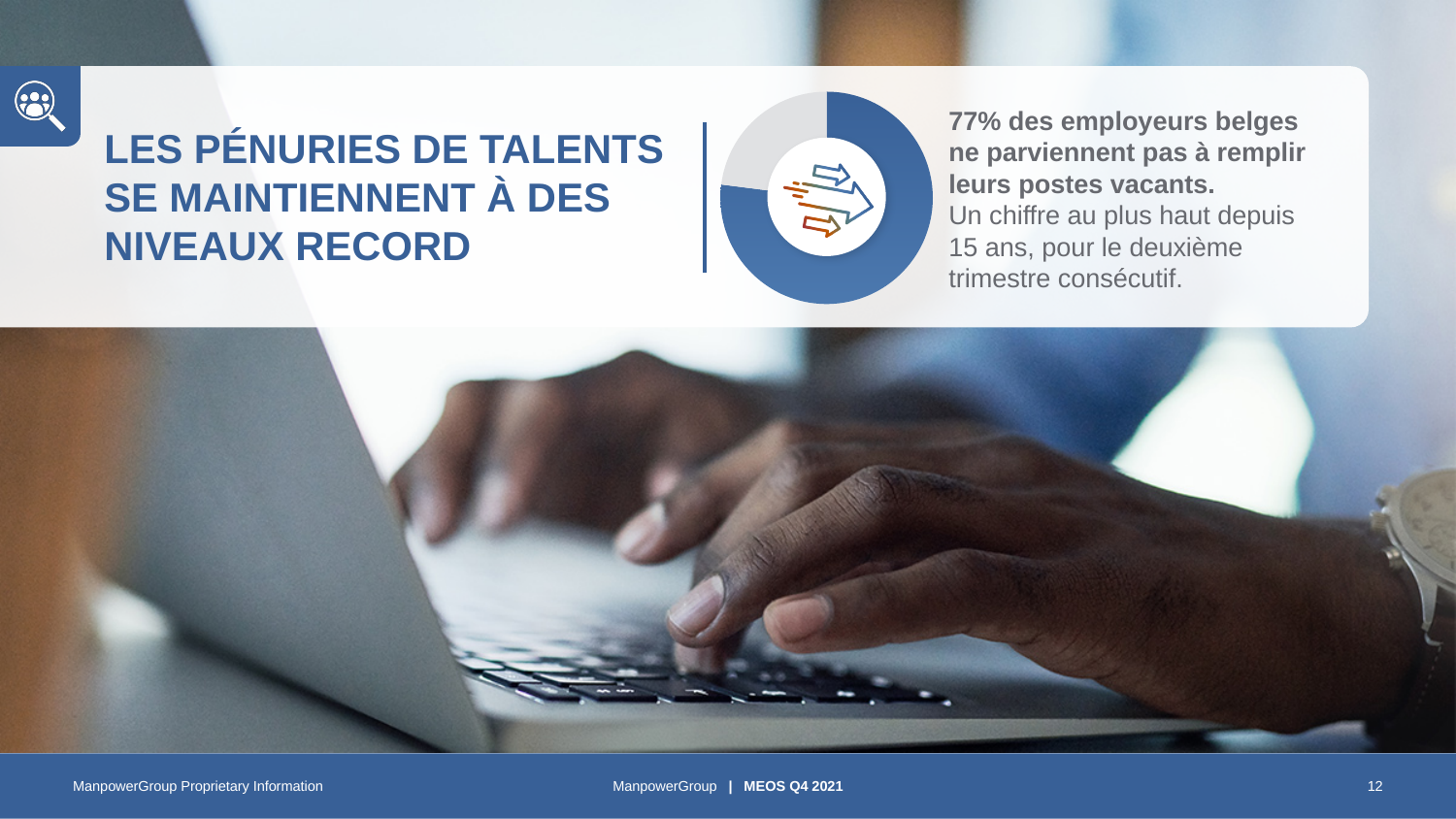
What colour is the larger segment of the donut chart? blue Is the blue segment of the donut chart greater or less than 50% of the whole? greater Which segment of the donut chart is larger, the blue one or the grey one? the blue one What kind of chart is shown on the slide? pie chart (donut) Is the grey segment of the donut chart greater or less than 50% of the whole? less What percentage of Belgian employers cannot fill their vacancies, according to the slide? 77% What share of the donut chart is filled in blue, according to the slide? 77% How many segments does the donut chart have? 2 What is the title of the slide containing the donut chart? LES PÉNURIES DE TALENTS SE MAINTIENNENT À DES NIVEAUX RECORD